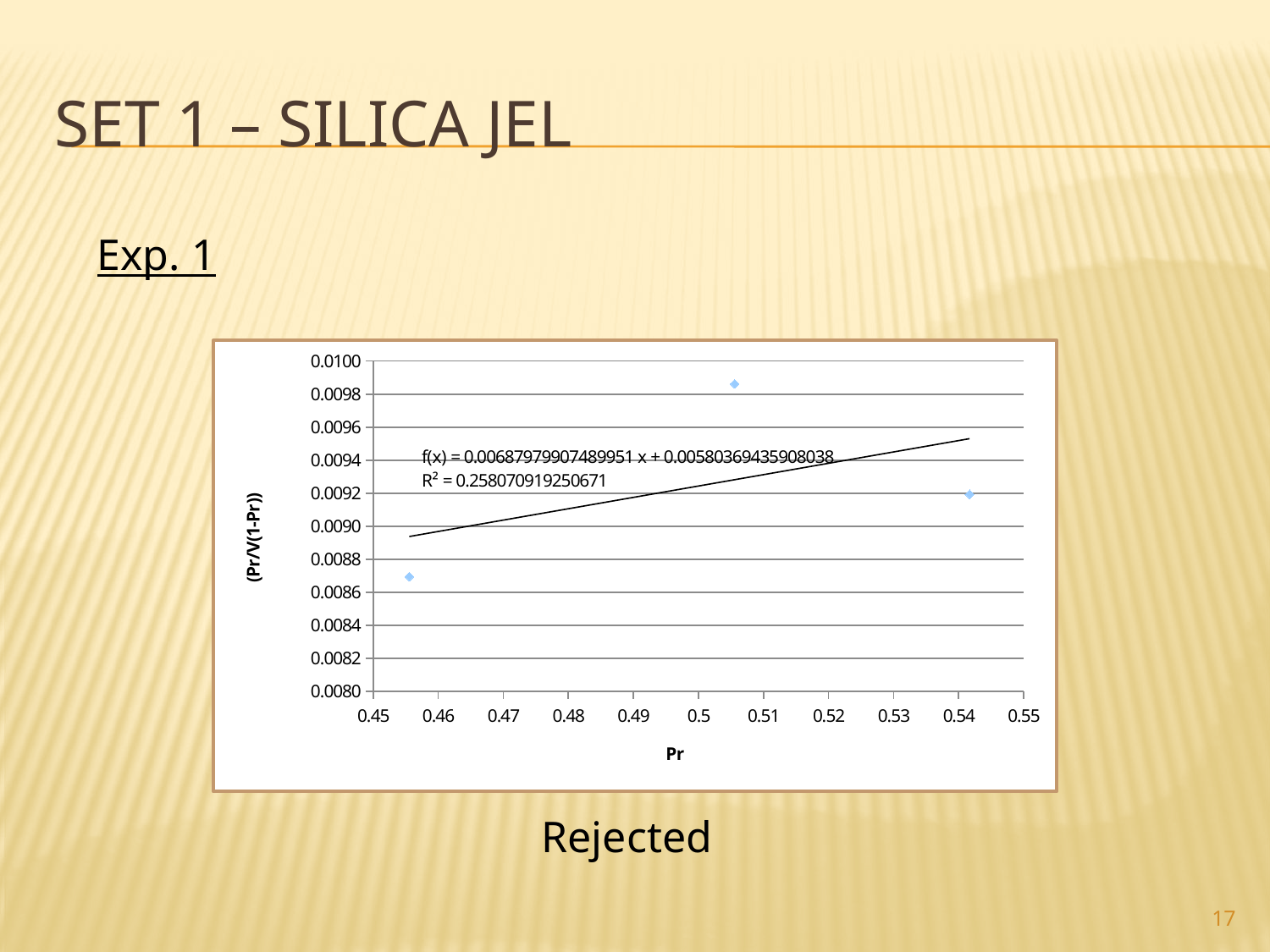
Which data point has the highest y value: the one near Pr = 0.505 or the one near Pr = 0.54? the one near Pr = 0.505 Does the fitted trendline rise or fall as Pr increases? rise What is the slope of the fitted line f(x) printed on the chart? 0.00687979907489951 Is the y value of the data point near Pr = 0.455 greater or less than 0.0090? less What R² value is printed on the chart? 0.258070919250671 Is the y value of the data point near Pr = 0.54 greater or less than 0.0090? greater Is the y value of the data point near Pr = 0.505 greater or less than 0.0096? greater What kind of chart is shown on the slide? scatter chart How many data points are plotted on the chart? 3 What is the intercept of the fitted line f(x) printed on the chart? 0.00580369435908038 What is the label of the y axis of the chart? (Pr/V(1-Pr)) What is the label of the x axis of the chart? Pr